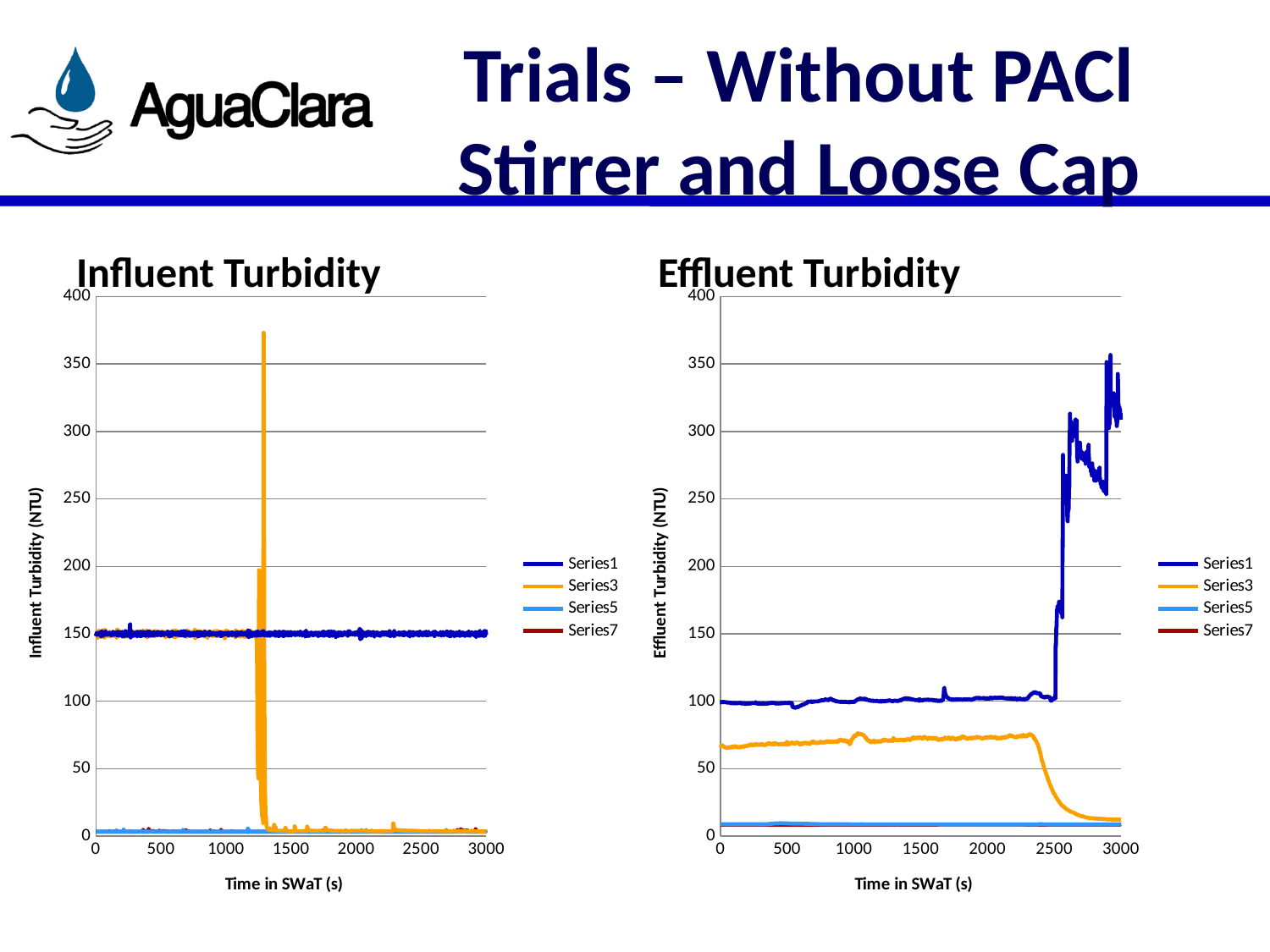
What type of chart is the Influent Turbidity chart? line chart In the Influent Turbidity chart, is the peak value of Series3 greater or less than 350? greater What is the y-axis title of the Effluent Turbidity chart? Effluent Turbidity (NTU) In the Effluent Turbidity chart, is the value of Series1 at 3000 s greater or less than 250? greater In the Influent Turbidity chart, is the value of Series1 at 2000 s greater or less than 100? greater What is the x-axis title of the Influent Turbidity chart? Time in SWaT (s) In the Effluent Turbidity chart, does Series3 rise or fall between 2300 s and 3000 s? fall How many series does the legend of the Effluent Turbidity chart list? 4 In the Effluent Turbidity chart, which series has the larger value at 1000 s, Series1 or Series3? Series1 In the Effluent Turbidity chart, which series reaches the highest value? Series1